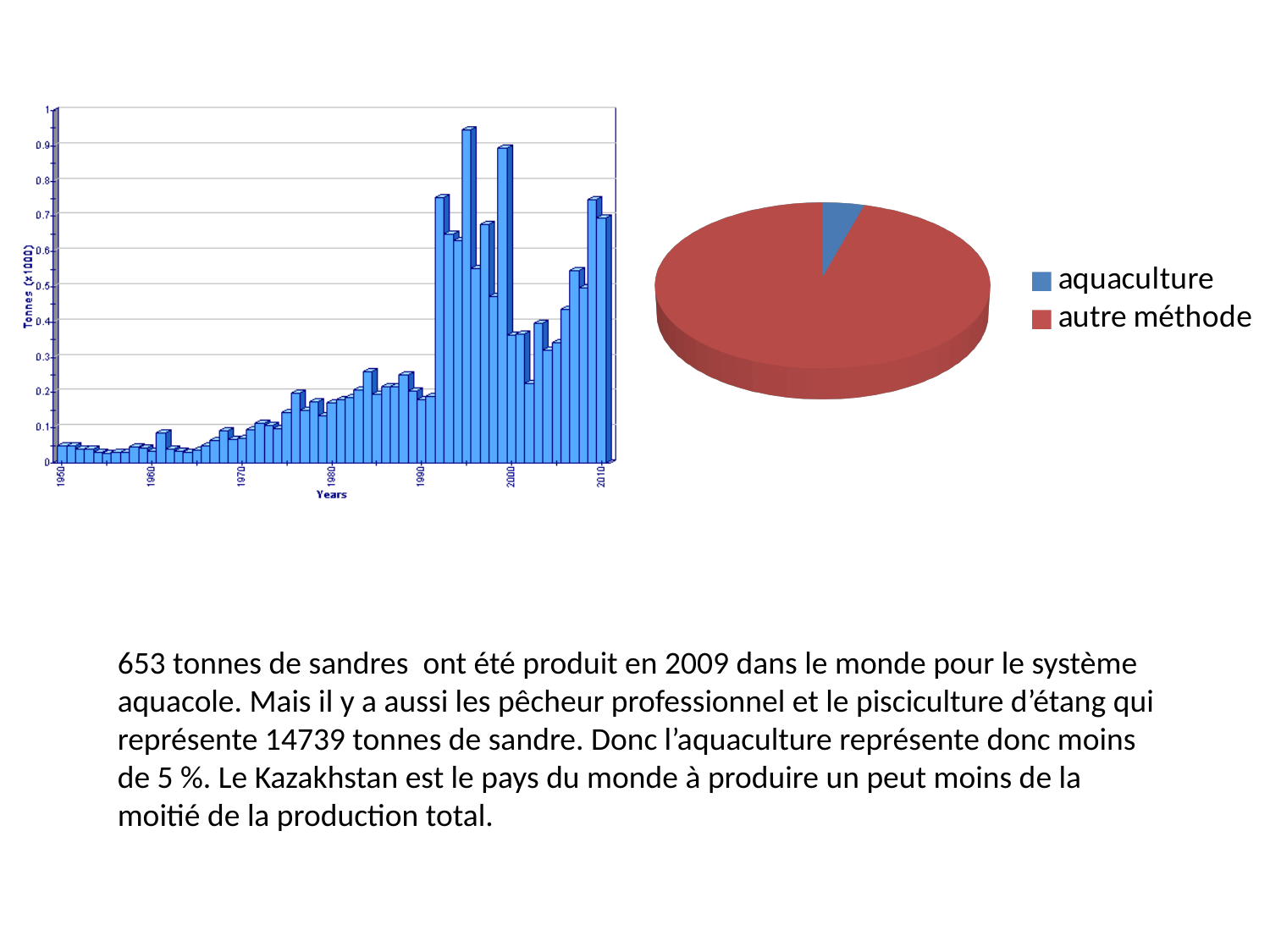
In the bar chart on the left, is the value for 1980 greater or less than 0.5? less In the pie chart on the right, which is larger: aquaculture or autre méthode? autre méthode In the bar chart on the left, is the value for 2010 greater or less than 0.5? greater In the pie chart on the right, what colour is the aquaculture slice? blue In the bar chart on the left, do the values generally rise or fall from 1950 to 2010? rise What kind of chart is the chart on the right of the slide? pie chart In the bar chart on the left, what is the label of the x axis? Years What kind of chart is the chart on the left of the slide? bar chart In the pie chart on the right, how many entries does the legend list? 2 In the pie chart on the right, which slice is the largest? autre méthode In the bar chart on the left, is the value for 1950 greater or less than 0.1? less In the pie chart on the right, which slice is the smallest? aquaculture